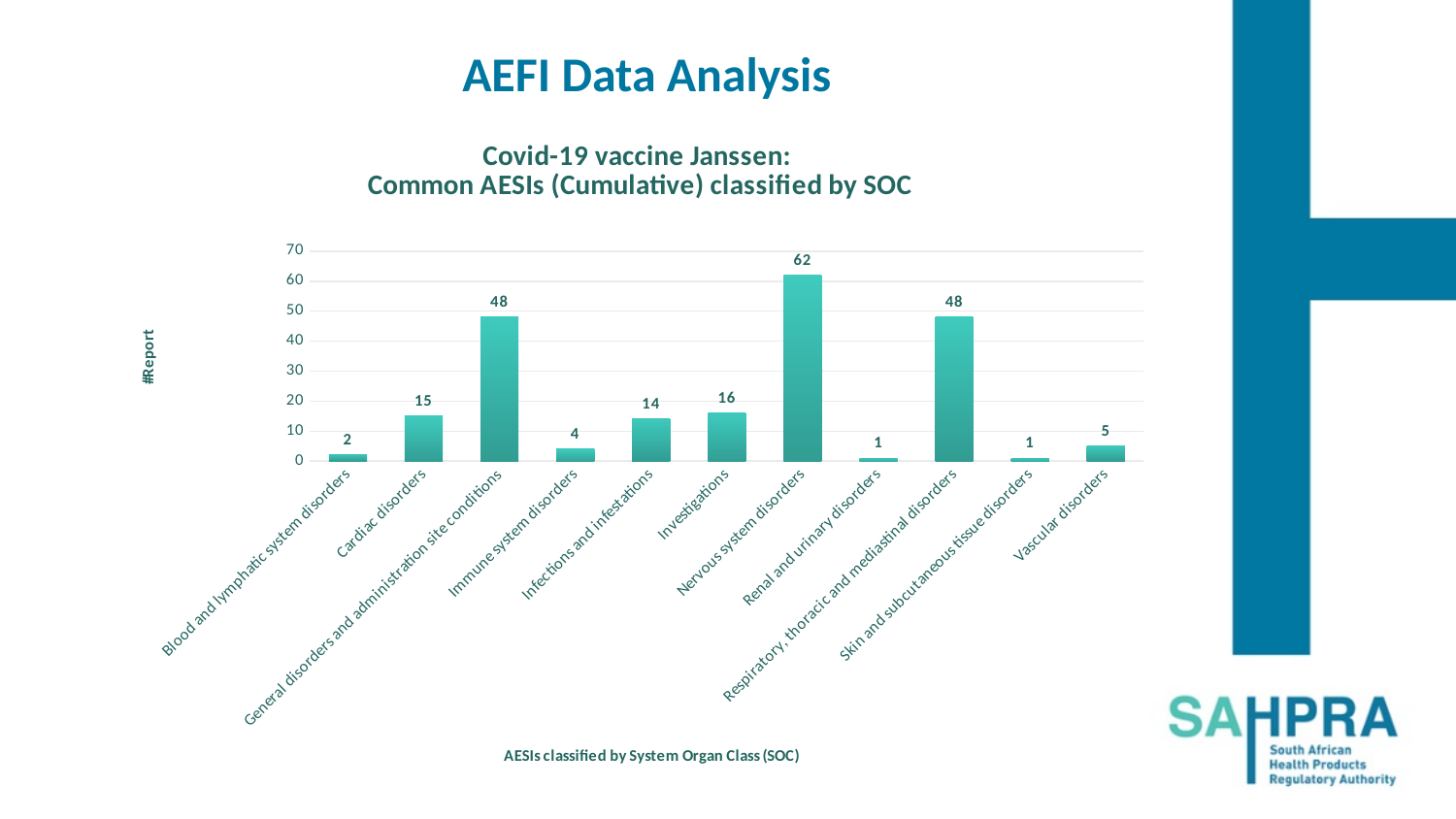
What is the label of the y axis? #Report What is the total number of reports for Blood and lymphatic system disorders and Vascular disorders combined? 7 How many categories are shown on the x axis? 11 Is the value for General disorders and administration site conditions greater or less than 40? greater What is the difference in reports between Nervous system disorders and Cardiac disorders? 47 Which category has the highest number of reports? Nervous system disorders What kind of chart is shown on the slide? Bar chart What is the number of reports for Nervous system disorders? 62 What is the number of reports for Investigations? 16 What is the title of the chart? Covid-19 vaccine Janssen: Common AESIs (Cumulative) classified by SOC Which has more reports, Infections and infestations or Immune system disorders? Infections and infestations What is the number of reports for Cardiac disorders? 15